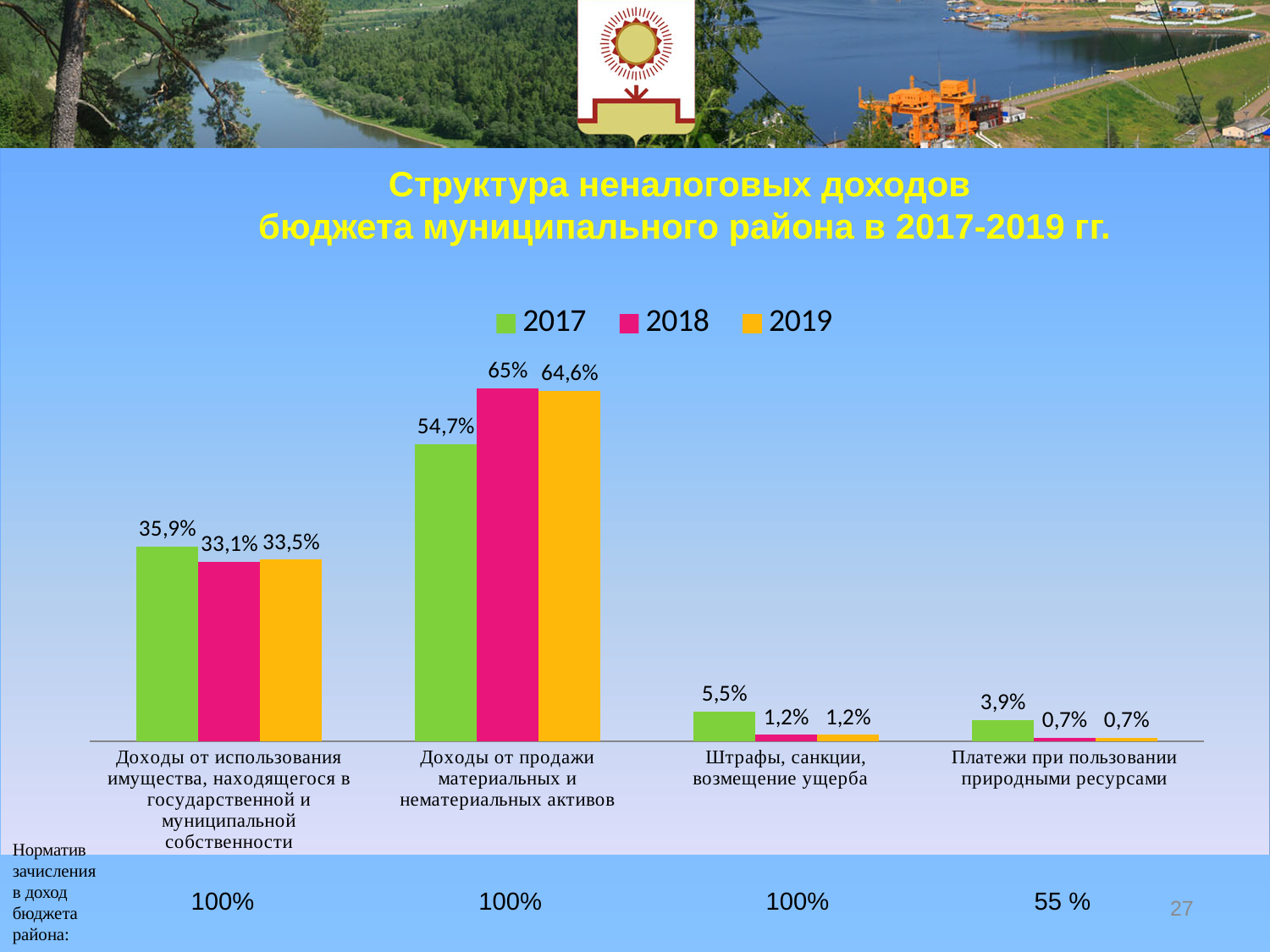
What is the 2019 value for «Штрафы, санкции, возмещение ущерба»? 1,2% Which is larger for «Доходы от использования имущества...»: the 2017 value or the 2019 value? 2017 What kind of chart is shown on the slide? Bar chart What is the 2017 value for «Платежи при пользовании природными ресурсами»? 3,9% What is the 2017 value for «Доходы от использования имущества, находящегося в государственной и муниципальной собственности»? 35,9% Which category has the highest value in 2019? Доходы от продажи материальных и нематериальных активов How many series does the legend list? 3 How many categories are shown on the x axis? 4 What is the difference between the 2018 and 2017 values for «Доходы от продажи материальных и нематериальных активов»? 10,3% What is the 2018 value for «Доходы от продажи материальных и нематериальных активов»? 65% Which category has the lowest value in 2018? Платежи при пользовании природными ресурсами Which colour represents the 2019 series in the legend? Orange